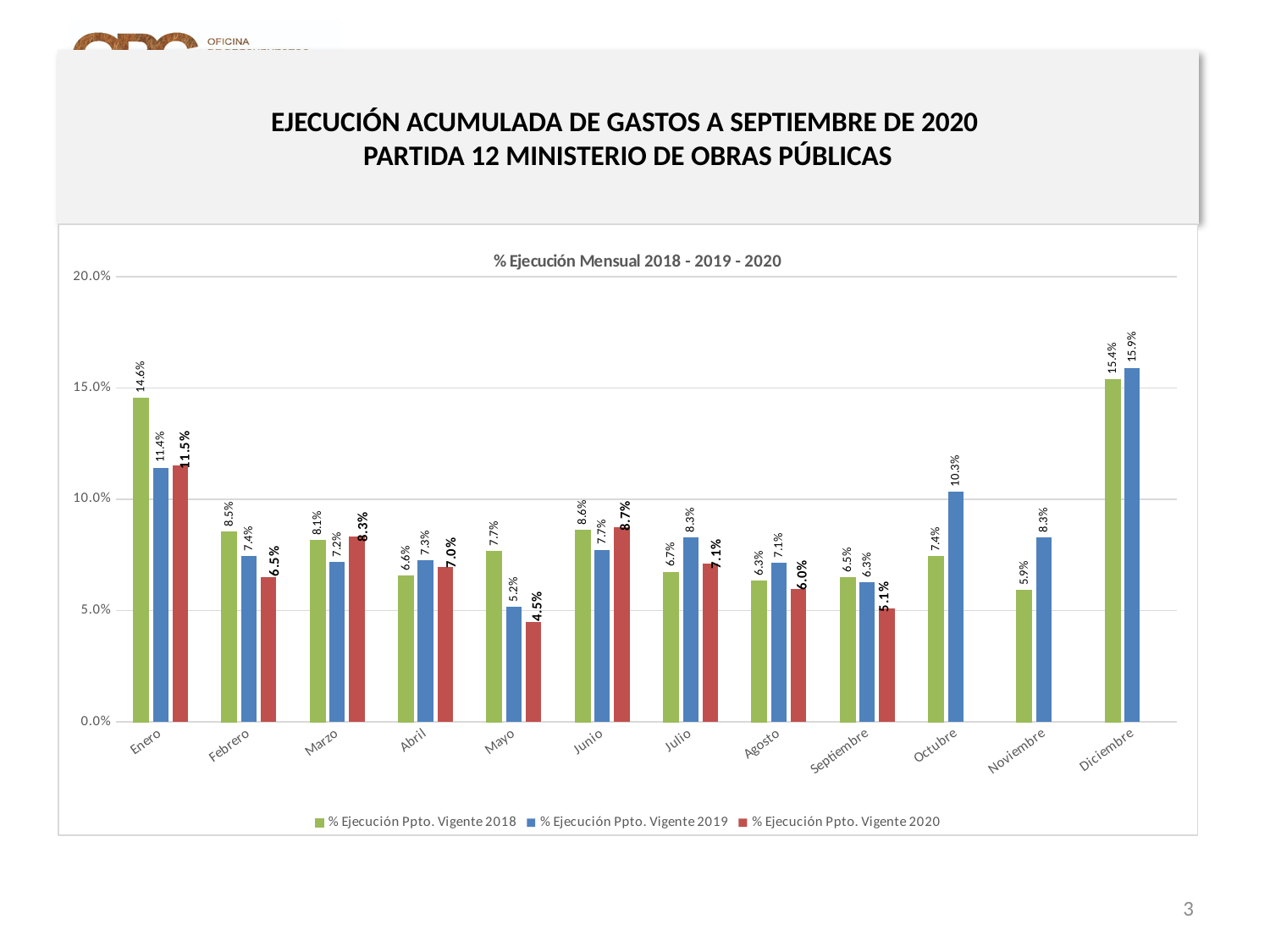
Which month has the lowest value for % Ejecución Ppto. Vigente 2020? Mayo How many months are shown on the x axis? 12 What is the value for % Ejecución Ppto. Vigente 2018 in Enero? 14.6% How many series does the legend list? 3 What kind of chart is shown on the slide? Bar chart What is the title of the chart? % Ejecución Mensual 2018 - 2019 - 2020 What is the value for % Ejecución Ppto. Vigente 2019 in Octubre? 10.3% What is the difference between the 2018 and 2019 values in Enero? 3.2% What is the value for % Ejecución Ppto. Vigente 2020 in Mayo? 4.5% Which is larger in Julio: the 2018 value or the 2019 value? 2019 Is the value for % Ejecución Ppto. Vigente 2019 in Diciembre greater or less than 15.0%? greater Which month has the highest value for % Ejecución Ppto. Vigente 2019? Diciembre